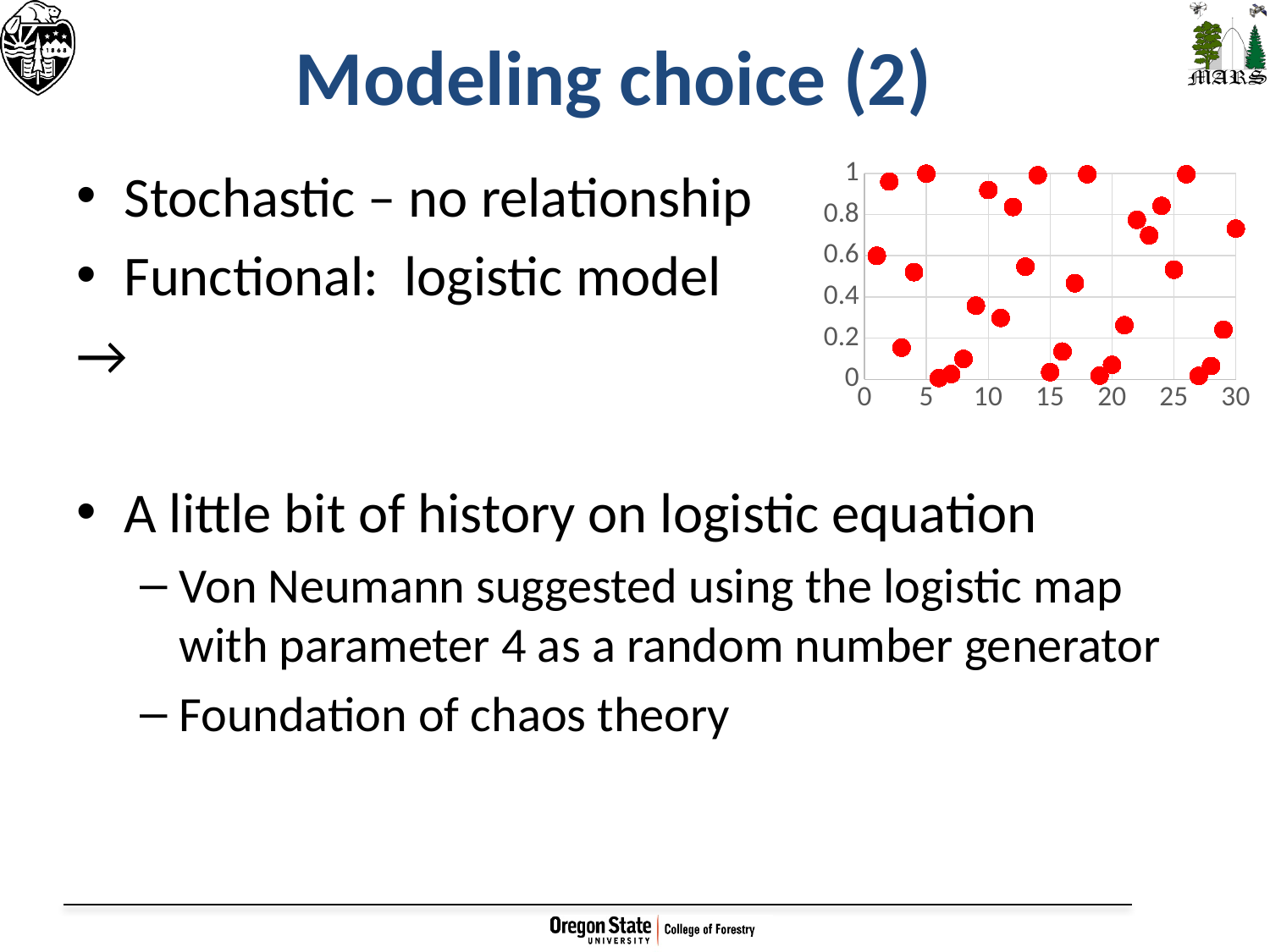
What is the highest value shown on the x axis of the chart? 30 Is the value of the point at x = 30 greater or less than 0.6? greater Is the value of the point at x = 15 greater or less than 0.2? less Do the points in the chart show a clear rising or falling trend along the x axis? no Is the value of the point at x = 5 greater or less than 0.8? greater How many data points are plotted in the chart? 30 What kind of chart is shown on the slide? scatter chart What colour are the data points in the chart? red